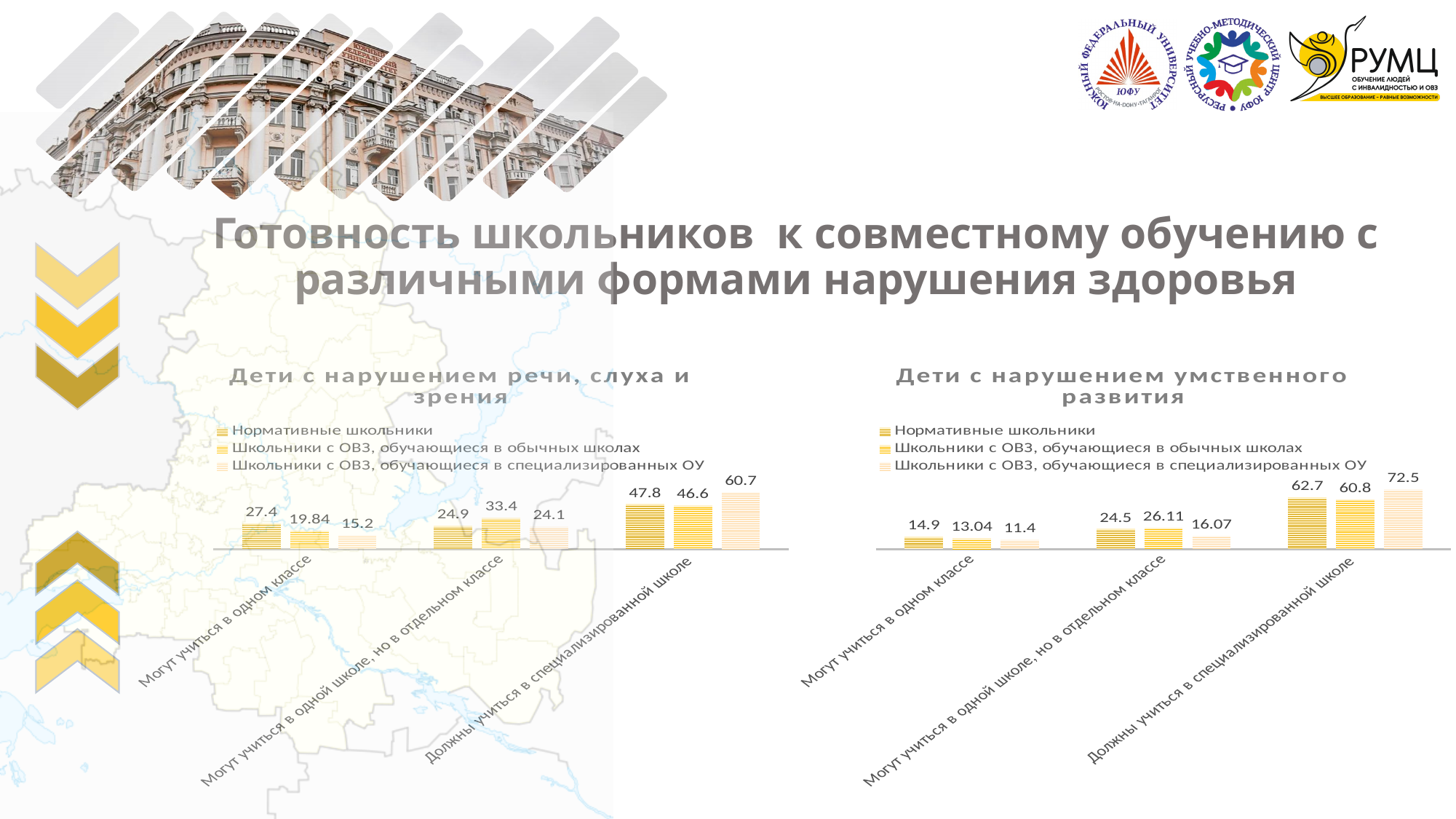
In the chart 'Дети с нарушением речи, слуха и зрения', which is larger in the category 'Могут учиться в одной школе, но в отдельном классе': the value for 'Нормативные школьники' or for 'Школьники с ОВЗ, обучающиеся в обычных школах'? Школьники с ОВЗ, обучающиеся в обычных школах In the chart 'Дети с нарушением речи, слуха и зрения', what is the difference between the values for 'Нормативные школьники' and 'Школьники с ОВЗ, обучающиеся в специализированных ОУ' in the category 'Могут учиться в одном классе'? 12.2 In the chart 'Дети с нарушением речи, слуха и зрения', what is the value for 'Нормативные школьники' in the category 'Могут учиться в одном классе'? 27.4 In the chart 'Дети с нарушением речи, слуха и зрения', do the values for 'Нормативные школьники' rise or fall from 'Могут учиться в одной школе, но в отдельном классе' to 'Должны учиться в специализированной школе'? Rise In the chart 'Дети с нарушением умственного развития', what is the value for 'Школьники с ОВЗ, обучающиеся в обычных школах' in the category 'Могут учиться в одной школе, но в отдельном классе'? 26.11 In the chart 'Дети с нарушением умственного развития', which series has the highest value in the category 'Должны учиться в специализированной школе'? Школьники с ОВЗ, обучающиеся в специализированных ОУ How many categories are shown on the x axis of the chart 'Дети с нарушением умственного развития'? 3 How many series does the legend of the chart 'Дети с нарушением речи, слуха и зрения' list? 3 What type of chart is 'Дети с нарушением умственного развития'? Bar chart In the chart 'Дети с нарушением умственного развития', what is the difference between the values for 'Школьники с ОВЗ, обучающиеся в специализированных ОУ' and 'Нормативные школьники' in the category 'Должны учиться в специализированной школе'? 9.8 In the chart 'Дети с нарушением речи, слуха и зрения', what is the value for 'Школьники с ОВЗ, обучающиеся в специализированных ОУ' in the category 'Должны учиться в специализированной школе'? 60.7 In the chart 'Дети с нарушением умственного развития', which series has the lowest value in the category 'Могут учиться в одном классе'? Школьники с ОВЗ, обучающиеся в специализированных ОУ